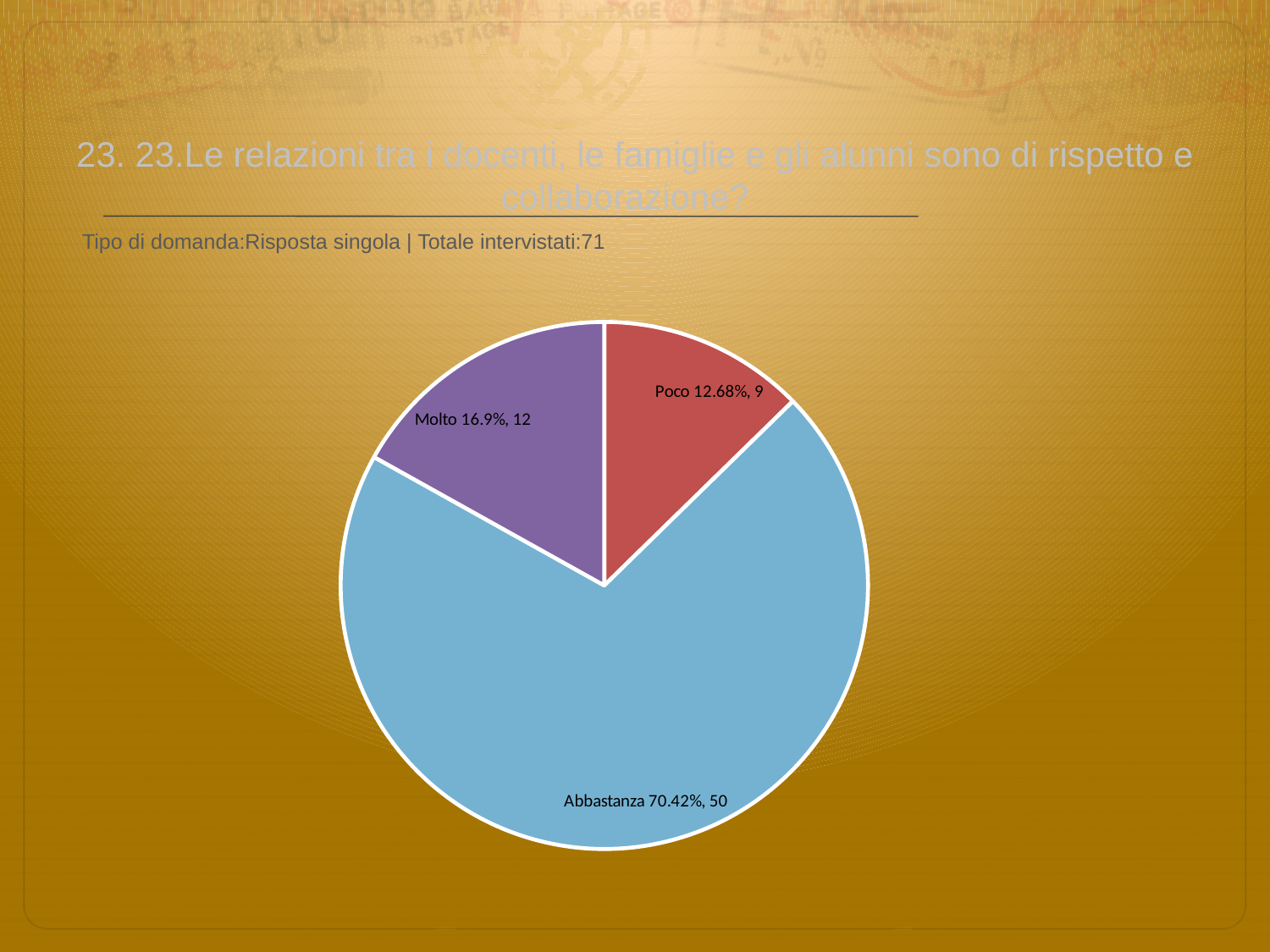
Which response has the largest slice of the pie? Abbastanza What colour is the Abbastanza slice? light blue How many respondents answered Poco? 9 What is the difference in respondent count between Abbastanza and Molto? 38 Which response has the smallest slice of the pie? Poco What percentage share does the Abbastanza slice have? 70.42% What kind of chart is shown on the slide? pie chart What is the total number of respondents across all slices? 71 How many slices does the pie chart have? 3 Which has more respondents, Molto or Poco? Molto What percentage share does the Poco slice have? 12.68% How many respondents answered Molto? 12